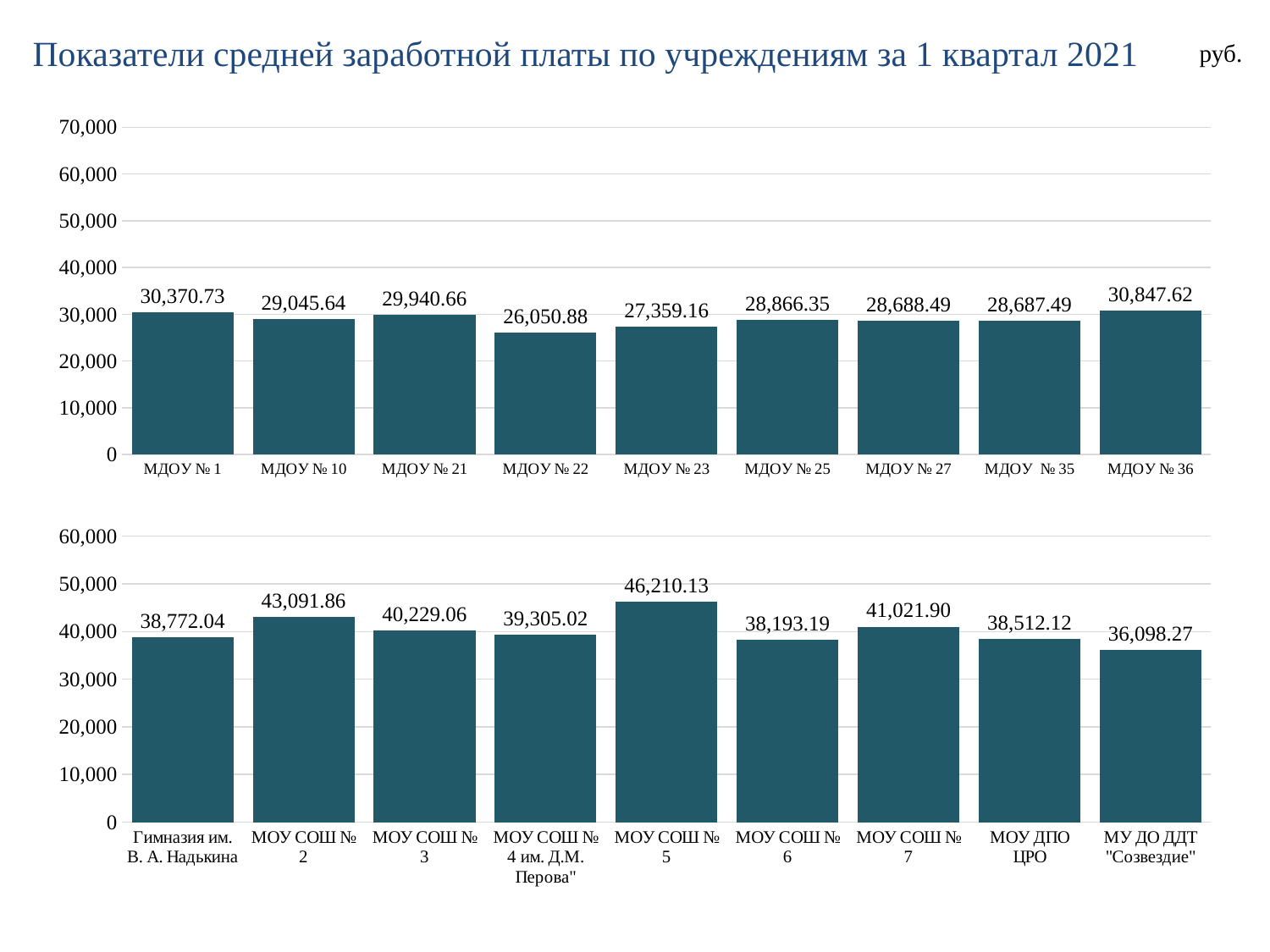
In the bottom chart, what is the difference between the values for МОУ СОШ № 5 and МОУ СОШ № 6? 8,016.94 In the top chart, which category has the highest value? МДОУ № 36 In the bottom chart, what is the value for МУ ДО ДДТ "Созвездие"? 36,098.27 What kind of chart is the top chart? bar chart In the bottom chart, which is larger: the value for МОУ СОШ № 2 or МОУ СОШ № 7? МОУ СОШ № 2 In the top chart, what is the value for МДОУ № 1? 30,370.73 In the top chart, what is the difference between the values for МДОУ № 36 and МДОУ № 22? 4,796.74 In the top chart, which category has the lowest value? МДОУ № 22 In the top chart, is the value for МДОУ № 22 greater or less than 30,000? less How many categories are shown in the bottom chart? 9 In the bottom chart, which category has the lowest value? МУ ДО ДДТ "Созвездие" In the bottom chart, what is the value for МОУ СОШ № 5? 46,210.13